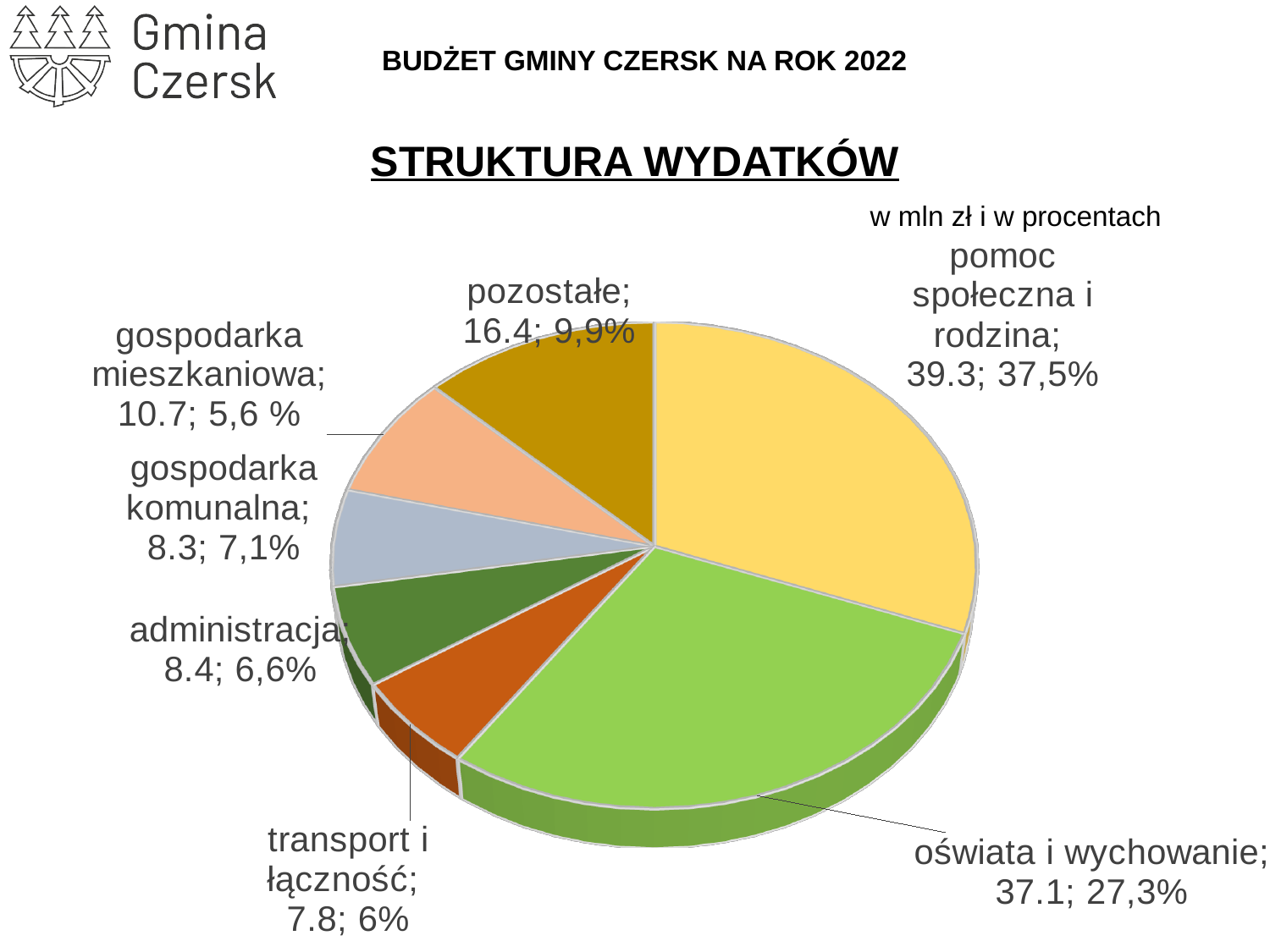
What is the difference in mln zł between 'pomoc społeczna i rodzina' and 'oświata i wychowanie'? 2.2 What percentage share is shown for 'gospodarka komunalna'? 7,1% What is the title of the chart? STRUKTURA WYDATKÓW What is the value in mln zł for 'transport i łączność'? 7.8 How many slices does the pie chart have? 7 Which category has the largest slice of the pie? pomoc społeczna i rodzina Which category has the smallest value in mln zł? transport i łączność Which has a larger value in mln zł: 'gospodarka mieszkaniowa' or 'administracja'? gospodarka mieszkaniowa What is the value in mln zł for 'pomoc społeczna i rodzina'? 39.3 What kind of chart is shown on the slide? pie chart What is the value in mln zł for 'pozostałe'? 16.4 What percentage share is shown for 'oświata i wychowanie'? 27,3%